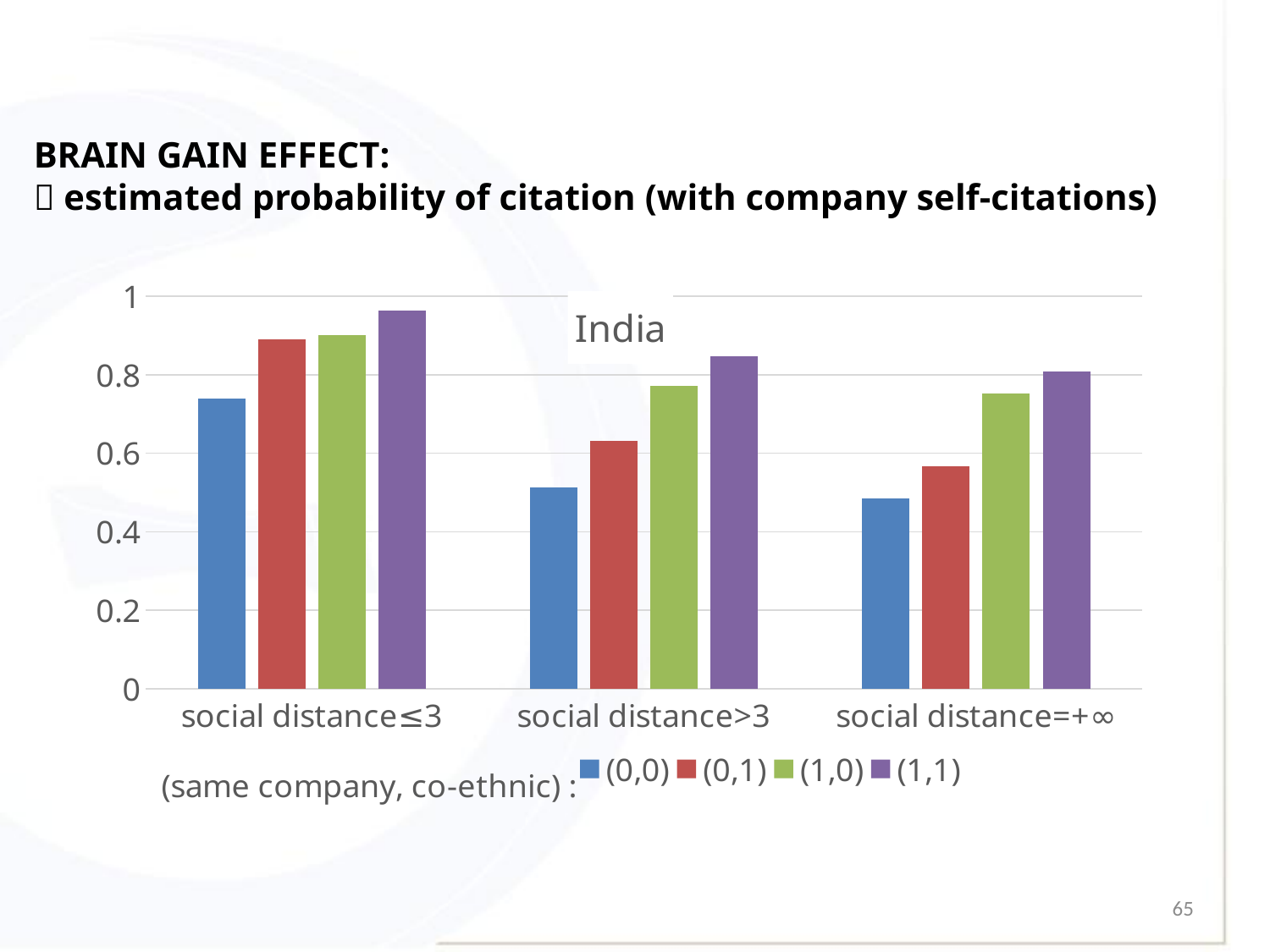
Does the value for (0,0) rise or fall across the categories from social distance≤3 to social distance=+∞? fall What kind of chart is shown on the slide? bar chart Is the value for (1,1) at social distance>3 greater or less than 0.8? greater How many categories are shown on the x axis? 3 Which series has the highest value in the social distance≤3 category? (1,1) How many series does the legend list? 4 Which series has the lowest value in the social distance>3 category? (0,0) Which colour represents the (1,1) series in the legend? purple Which is larger: the (0,1) value at social distance>3 or the (1,0) value at social distance>3? (1,0) Is the value for (0,0) at social distance=+∞ greater or less than 0.6? less What is the title of the chart? India Is the value for (0,0) at social distance≤3 greater or less than 0.6? greater